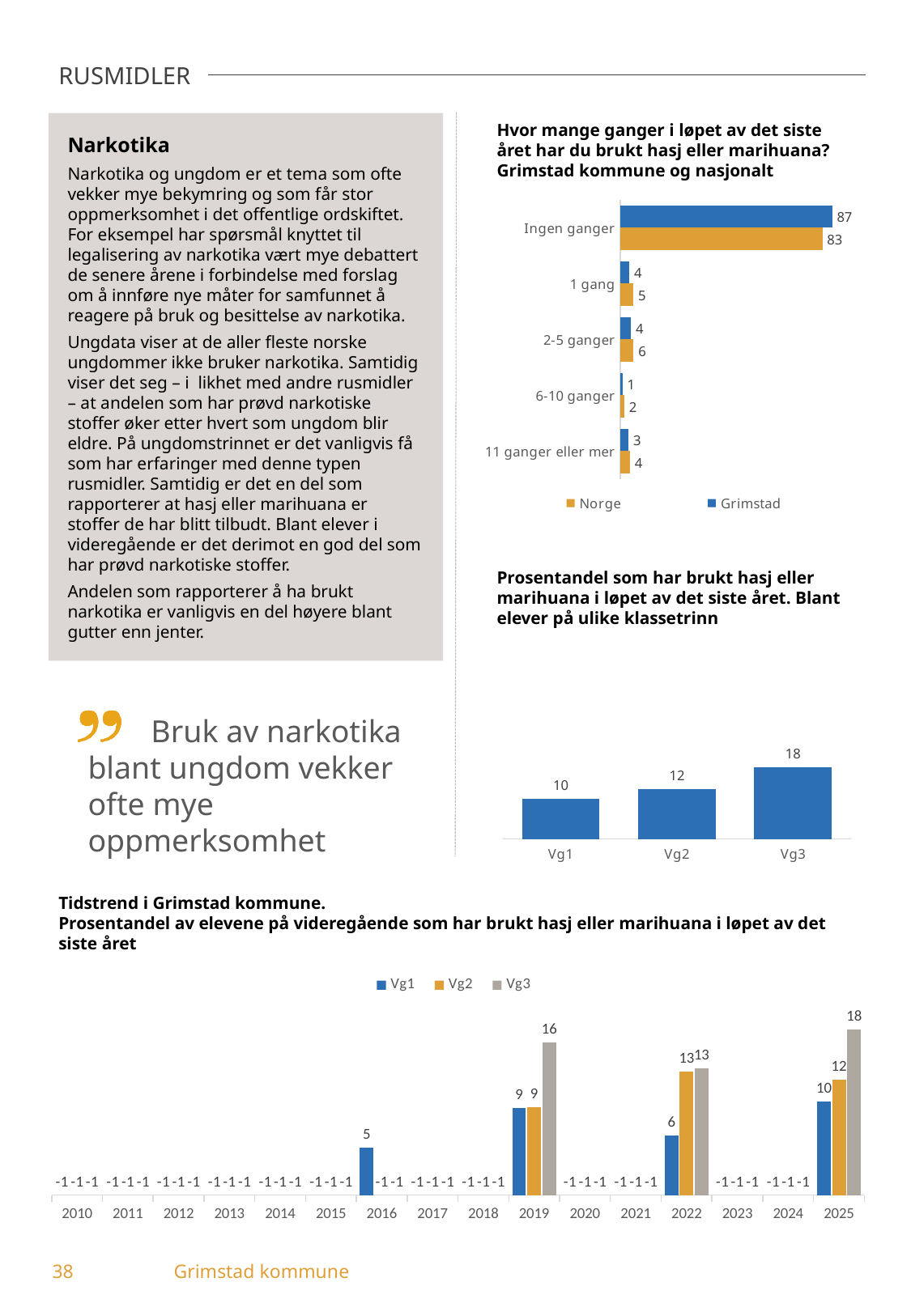
In the chart 'Hvor mange ganger i løpet av det siste året har du brukt hasj eller marihuana?', how many categories are shown? 5 In the chart 'Tidstrend i Grimstad kommune', how many series does the legend list? 3 In the chart 'Prosentandel som har brukt hasj eller marihuana i løpet av det siste året', do the values rise or fall from Vg1 to Vg3? rise In the chart 'Tidstrend i Grimstad kommune', which is larger in 2022: Vg1 or Vg2? Vg2 In the chart 'Tidstrend i Grimstad kommune', what is the value for Vg1 in 2016? 5 In the chart 'Prosentandel som har brukt hasj eller marihuana i løpet av det siste året', which class level has the highest value? Vg3 In the chart 'Hvor mange ganger i løpet av det siste året har du brukt hasj eller marihuana?', which series is shown in orange? Norge In the chart 'Hvor mange ganger i løpet av det siste året har du brukt hasj eller marihuana?', what is the value for Grimstad in the category 'Ingen ganger'? 87 In the chart 'Hvor mange ganger i løpet av det siste året har du brukt hasj eller marihuana?', what is the difference between Grimstad and Norge for 'Ingen ganger'? 4 In the chart 'Prosentandel som har brukt hasj eller marihuana i løpet av det siste året', what is the value for Vg2? 12 In the chart 'Tidstrend i Grimstad kommune', what is the value for Vg3 in 2019? 16 In the chart 'Hvor mange ganger i løpet av det siste året har du brukt hasj eller marihuana?', what is the value for Norge in the category '2-5 ganger'? 6